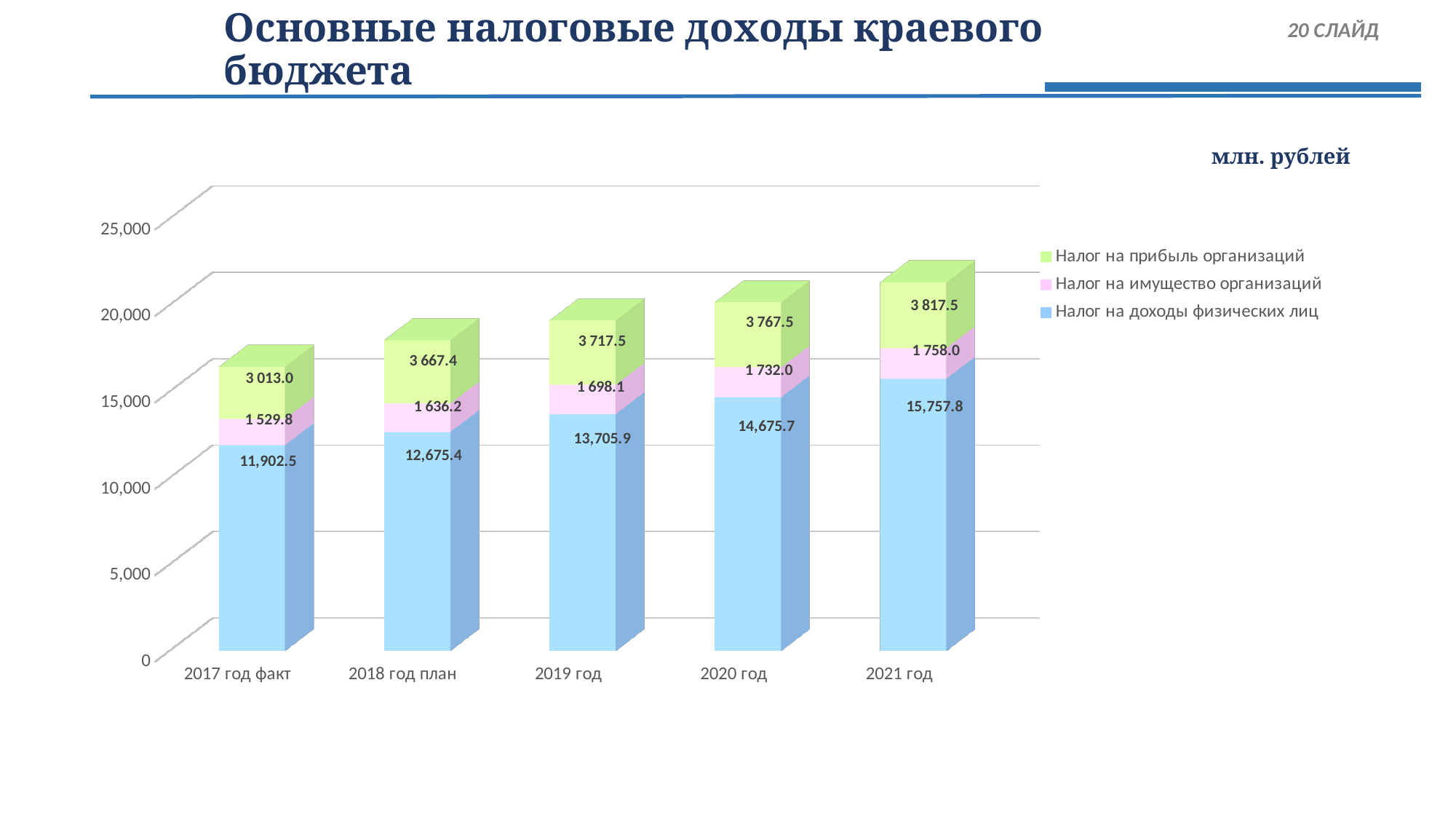
In which year is Налог на прибыль организаций the lowest? 2017 год факт How many series does the legend list? 3 In which year is Налог на доходы физических лиц the highest? 2021 год What is the difference between Налог на доходы физических лиц in 2021 год and in 2017 год факт? 3,855.3 Which is larger: Налог на имущество организаций in 2018 год план or in 2020 год? 2020 год What is the total of the stacked bar for 2020 год? 20,175.2 How many year categories are shown on the x axis? 5 What is the value of Налог на прибыль организаций for 2019 год? 3 717.5 What is the value of Налог на имущество организаций for 2021 год? 1 758.0 Does Налог на доходы физических лиц rise or fall from 2017 год факт to 2021 год? rise What is the value of Налог на доходы физических лиц for 2017 год факт? 11,902.5 What type of chart is shown on the slide? stacked bar chart